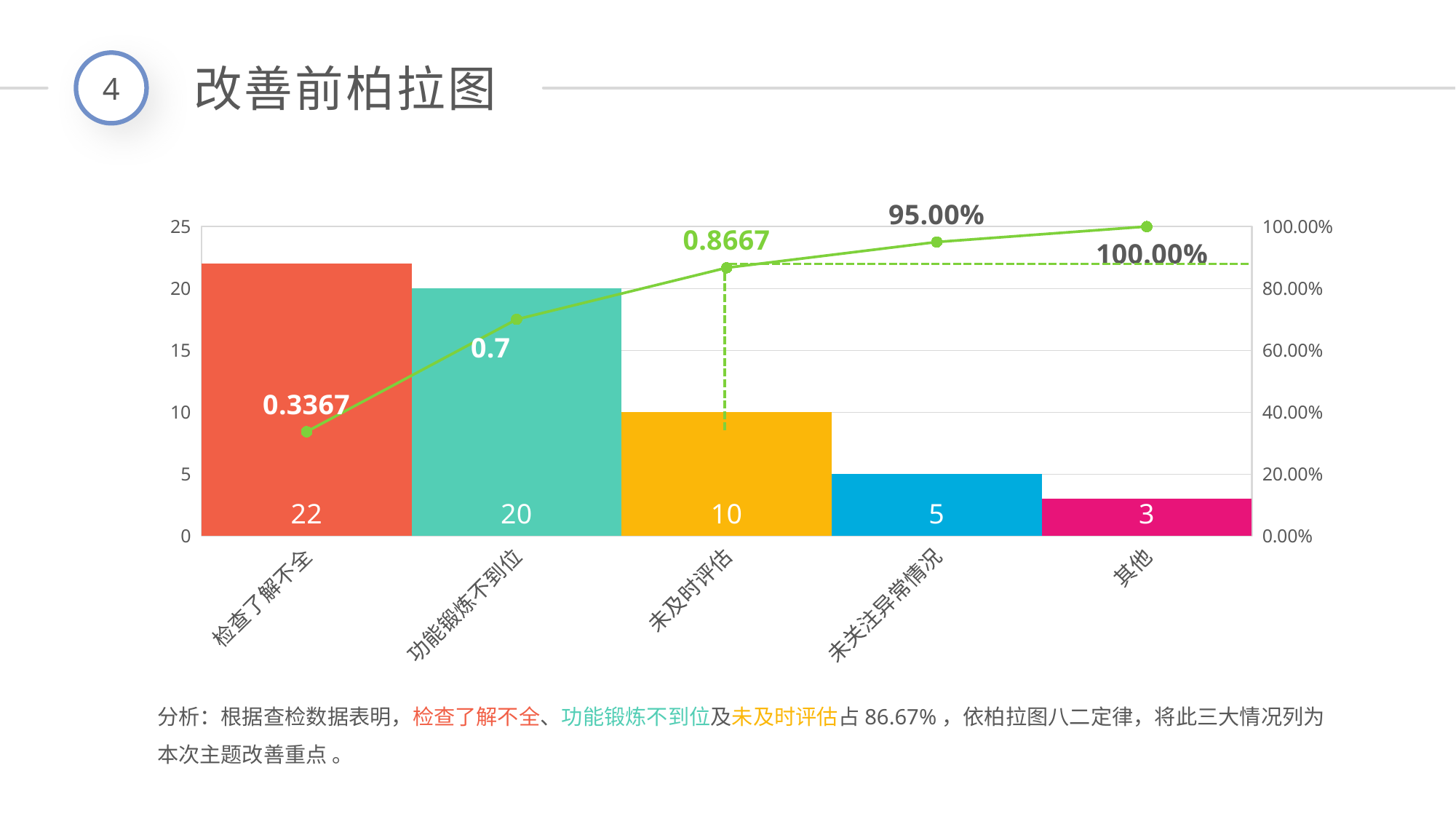
Which category has the highest bar? 检查了解不全 What is the value of the bar for 未及时评估? 10 What is the value of the bar for 其他? 3 What is the title of the slide containing the chart? 改善前柏拉图 What is the value of the bar for 检查了解不全? 22 How many categories are shown on the x axis? 5 What cumulative value label is shown on the line at 功能锻炼不到位? 0.7 Which category has the lowest bar? 其他 What cumulative percentage label is shown on the line at 未关注异常情况? 95.00% What is the difference between the bar values for 检查了解不全 and 未及时评估? 12 Which bar is larger, 功能锻炼不到位 or 未关注异常情况? 功能锻炼不到位 Do the bar values rise or fall from left to right along the x axis? fall